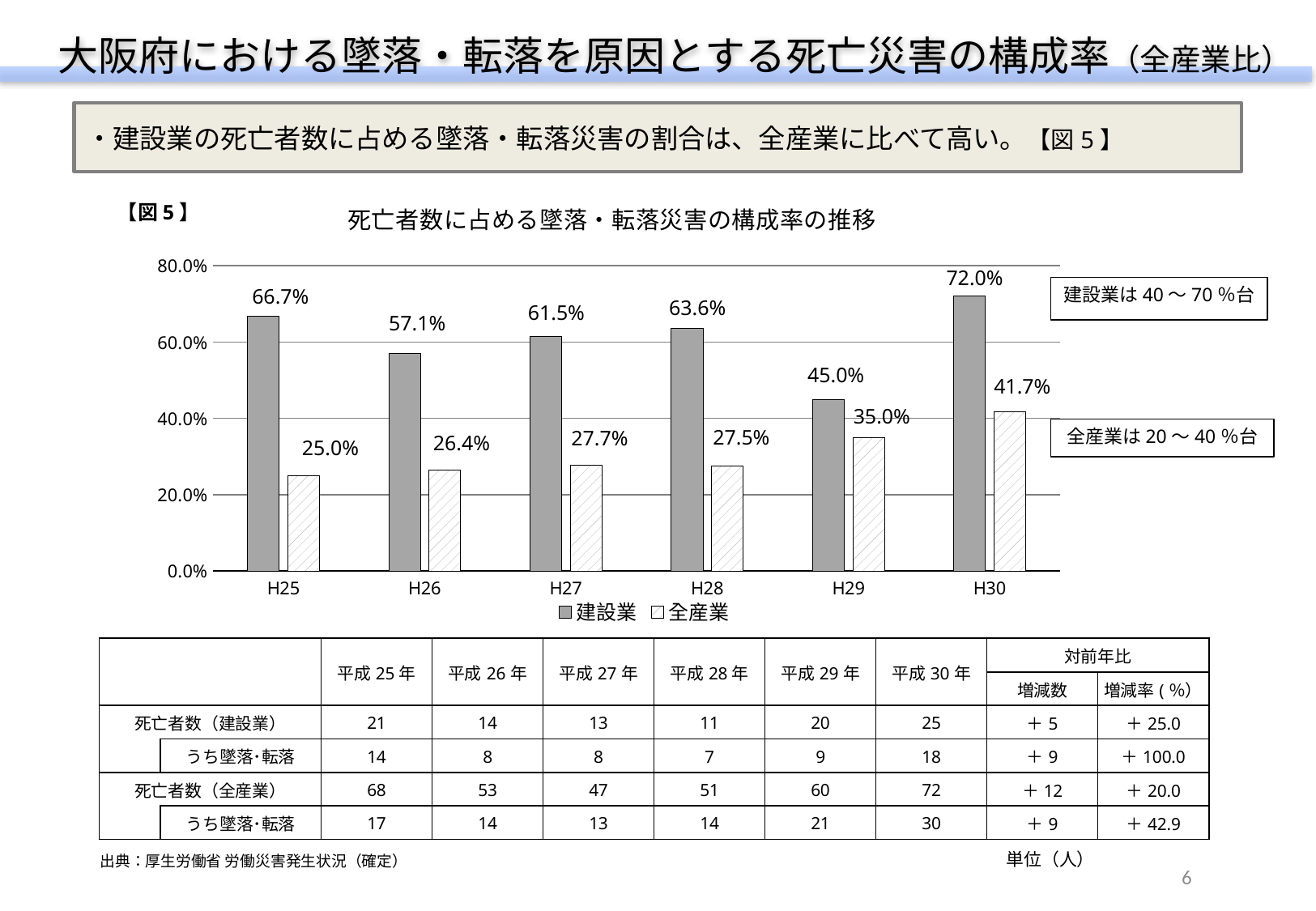
What kind of chart is shown? bar chart In which year is the 建設業 value lowest? H29 How many years are shown on the x axis? 6 In which year is the 建設業 value highest? H30 What is the title of the chart? 死亡者数に占める墜落・転落災害の構成率の推移 What is the value for 全産業 in H30? 41.7% How many series does the legend list? 2 What is the value for 建設業 in H25? 66.7% In which year is the 全産業 value lowest? H25 What is the value for 全産業 in H27? 27.7% What is the difference between the 建設業 and 全産業 values in H30? 30.3% Which is larger in H29, the 建設業 value or the 全産業 value? 建設業